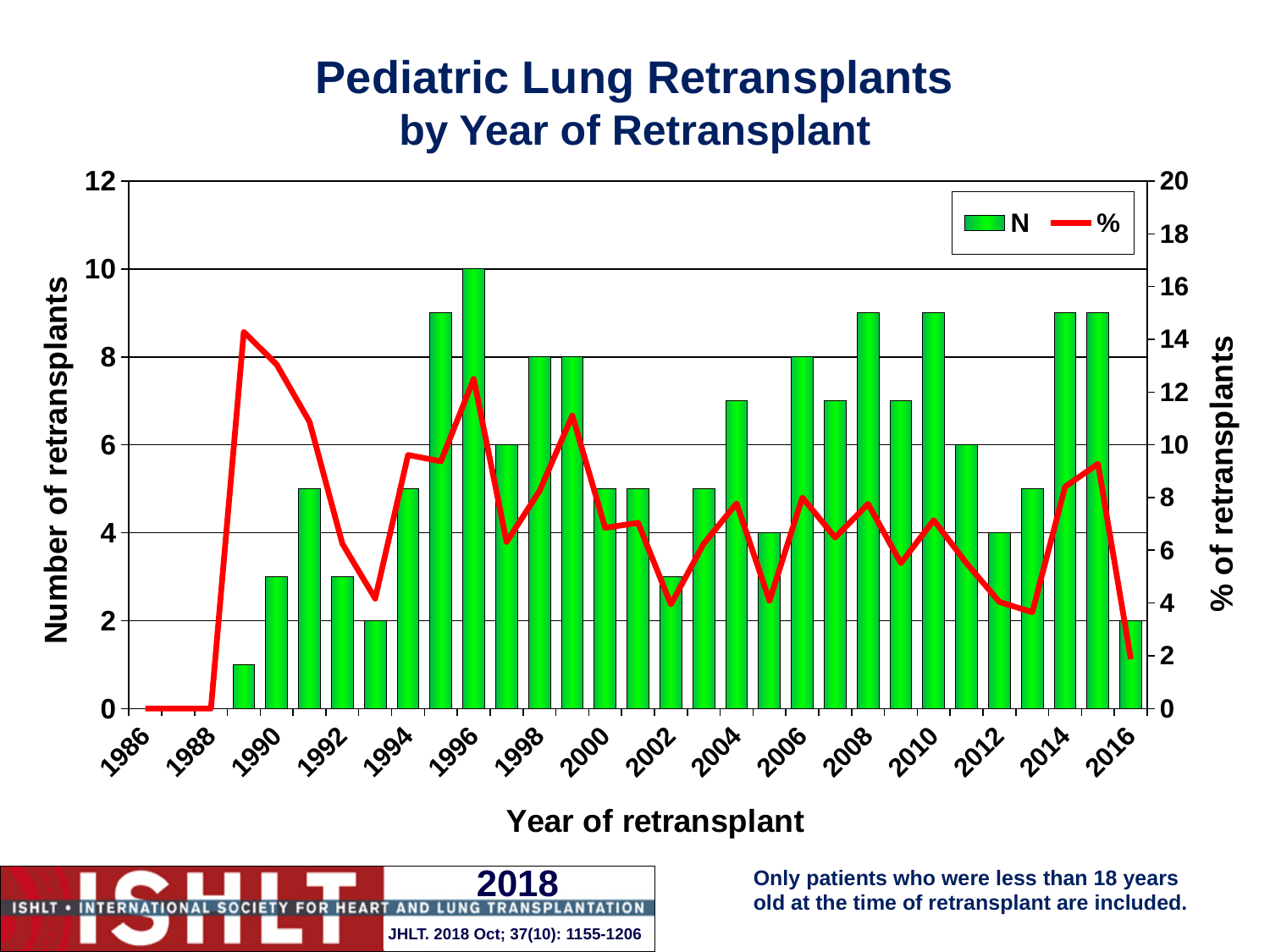
What is the number of retransplants (N) in 2012? 4 Does the % line rise or fall from 1989 to 1993? fall What is the number of retransplants (N) in 1996? 10 What is the number of retransplants (N) in 1998? 8 Which year has the tallest bar for N (number of retransplants)? 1996 What is the difference in the number of retransplants (N) between 1996 and 1998? 2 Which year has the larger number of retransplants (N), 2004 or 2005? 2004 How many series does the legend list? 2 Is the number of retransplants (N) in 1995 greater or less than 8? greater What is the title of the right-hand vertical axis? % of retransplants Is the number of retransplants (N) in 2002 greater or less than 4? less What is the number of retransplants (N) in 2016? 2